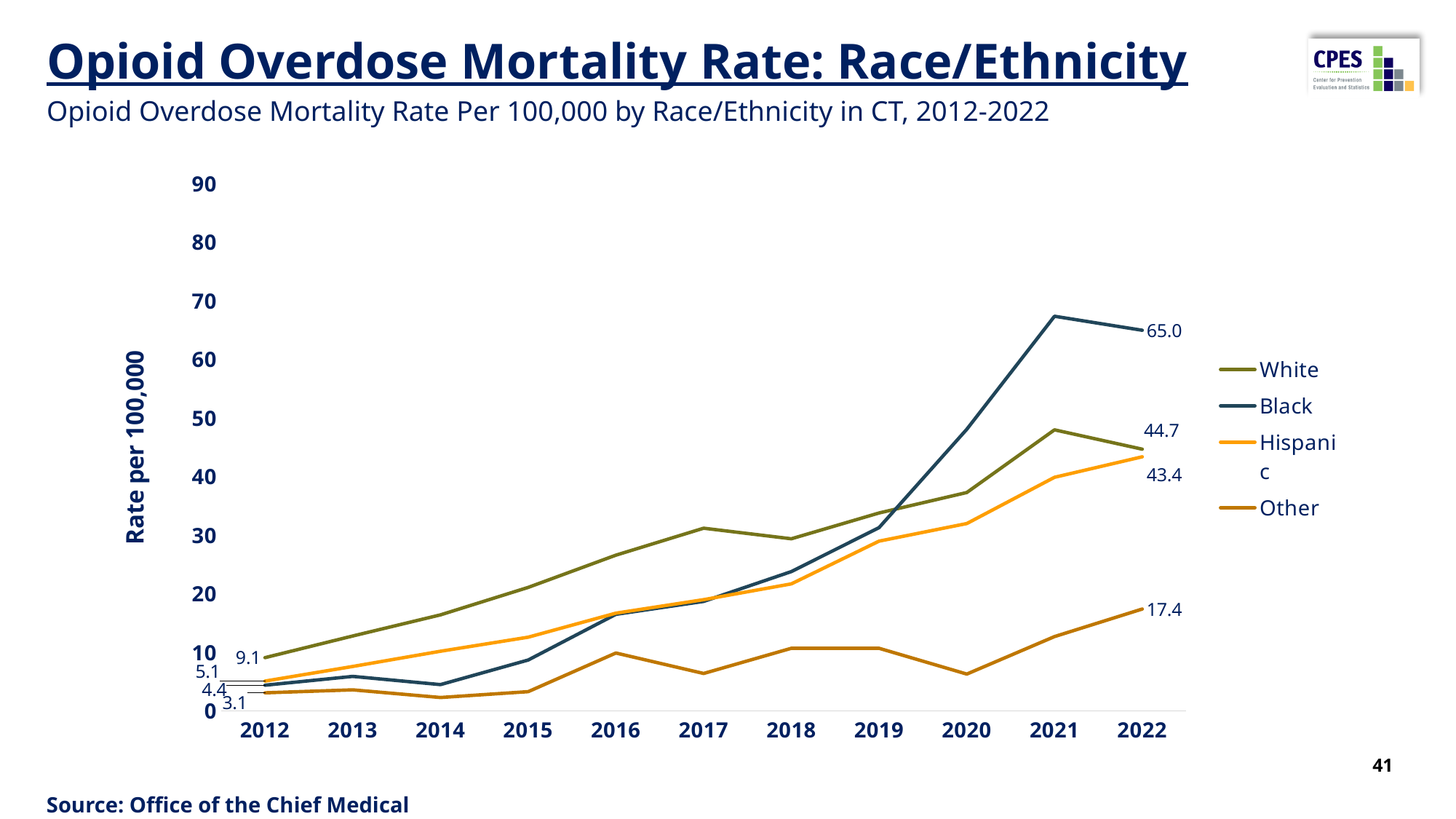
What is the opioid overdose mortality rate for Black residents in 2022? 65.0 What kind of chart is shown on the slide? line chart Which race/ethnicity group has the lowest mortality rate in 2022? Other What is the opioid overdose mortality rate for the Other group in 2022? 17.4 Is the mortality rate for Black residents in 2021 greater or less than 60? greater Which race/ethnicity group has the highest mortality rate in 2022? Black In 2012, which group had the higher mortality rate, Hispanic or Black? Hispanic Does the mortality rate for Black residents rise or fall from 2012 to 2022? rise What is the opioid overdose mortality rate for White residents in 2012? 9.1 What is the difference between the Black and White mortality rates in 2022? 20.3 How many years are shown on the x axis? 11 How many series does the legend list? 4